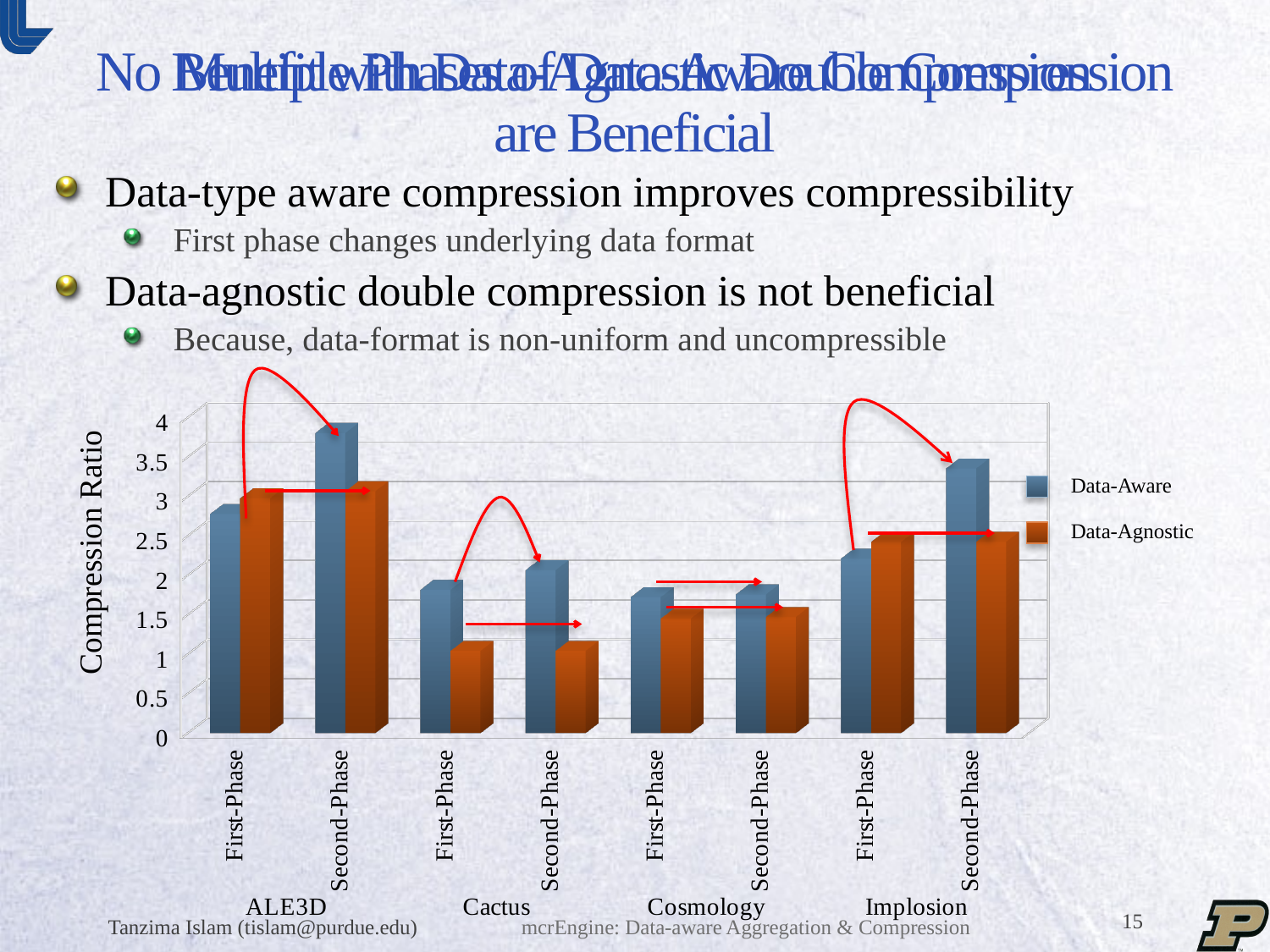
What are the two series named in the chart's legend? Data-Aware and Data-Agnostic How many datasets (category groups) are shown along the x axis of the chart? 4 Is the Data-Aware value for Implosion Second-Phase greater or less than 3? greater What kind of chart is shown on the slide? bar chart For Implosion First-Phase, which series has the larger value, Data-Aware or Data-Agnostic? Data-Agnostic How many series does the chart's legend list? 2 Is the Data-Aware value for ALE3D Second-Phase greater or less than 3.5? greater For Cactus Second-Phase, which series has the larger value, Data-Aware or Data-Agnostic? Data-Aware Which category has the highest Data-Aware compression ratio? ALE3D Second-Phase What is the title of the chart's vertical axis? Compression Ratio How many bars does the Data-Aware series have in the chart? 8 Is the Data-Agnostic value for Cactus First-Phase greater or less than 1.5? less